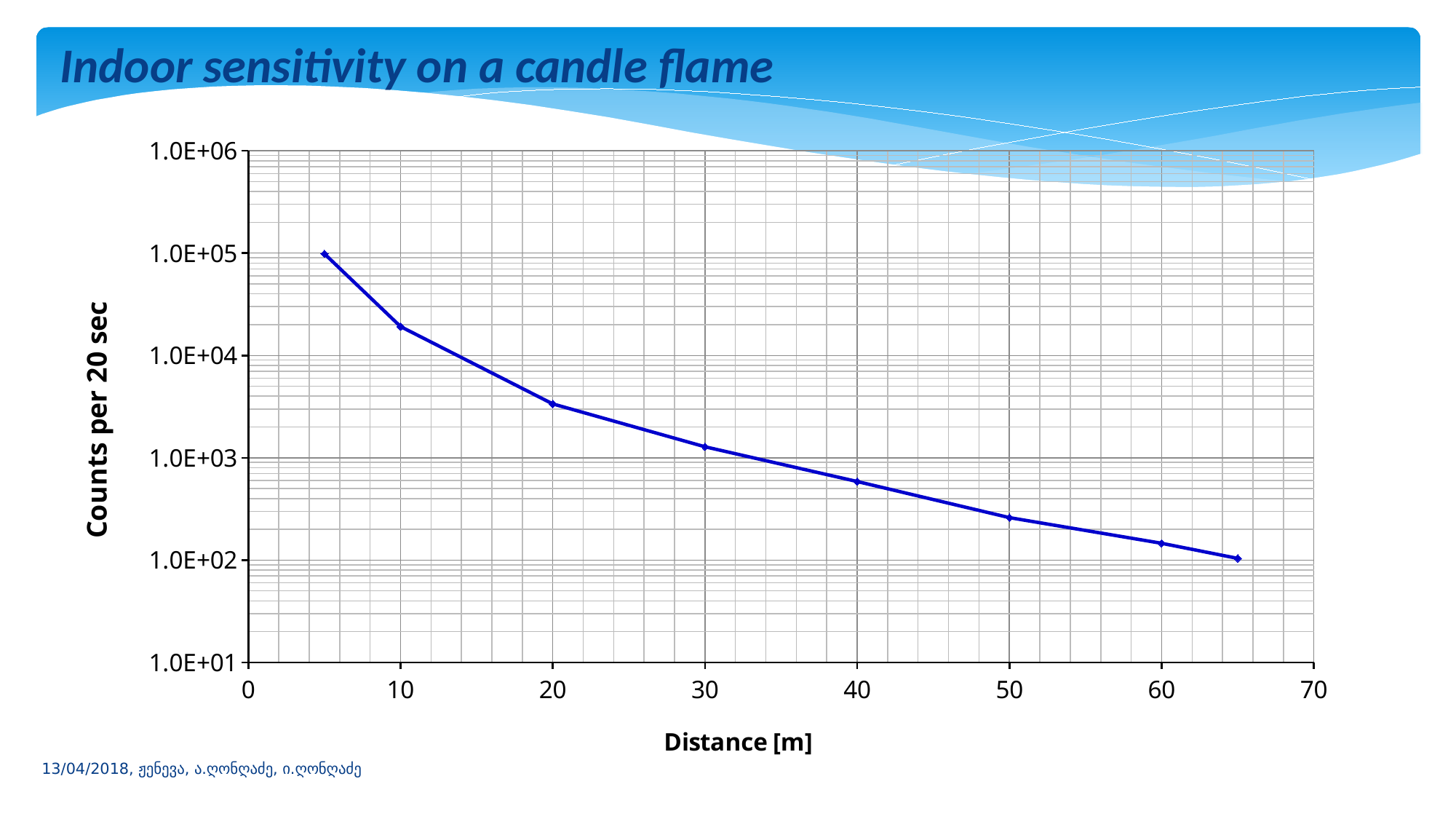
Which has the larger counts per 20 sec value, 10 m or 20 m? 10 m Is the value at 40 m greater or less than 1.0E+03? less What is the label of the y axis? Counts per 20 sec At which distance is the counts per 20 sec value highest? 5 m How many data points are plotted on the line? 8 What is the title of the chart? Indoor sensitivity on a candle flame At which distance is the counts per 20 sec value lowest? 65 m Is the value at 10 m greater or less than 1.0E+04? greater What kind of chart is shown on the slide? Line chart Do the counts rise or fall as distance increases? Fall